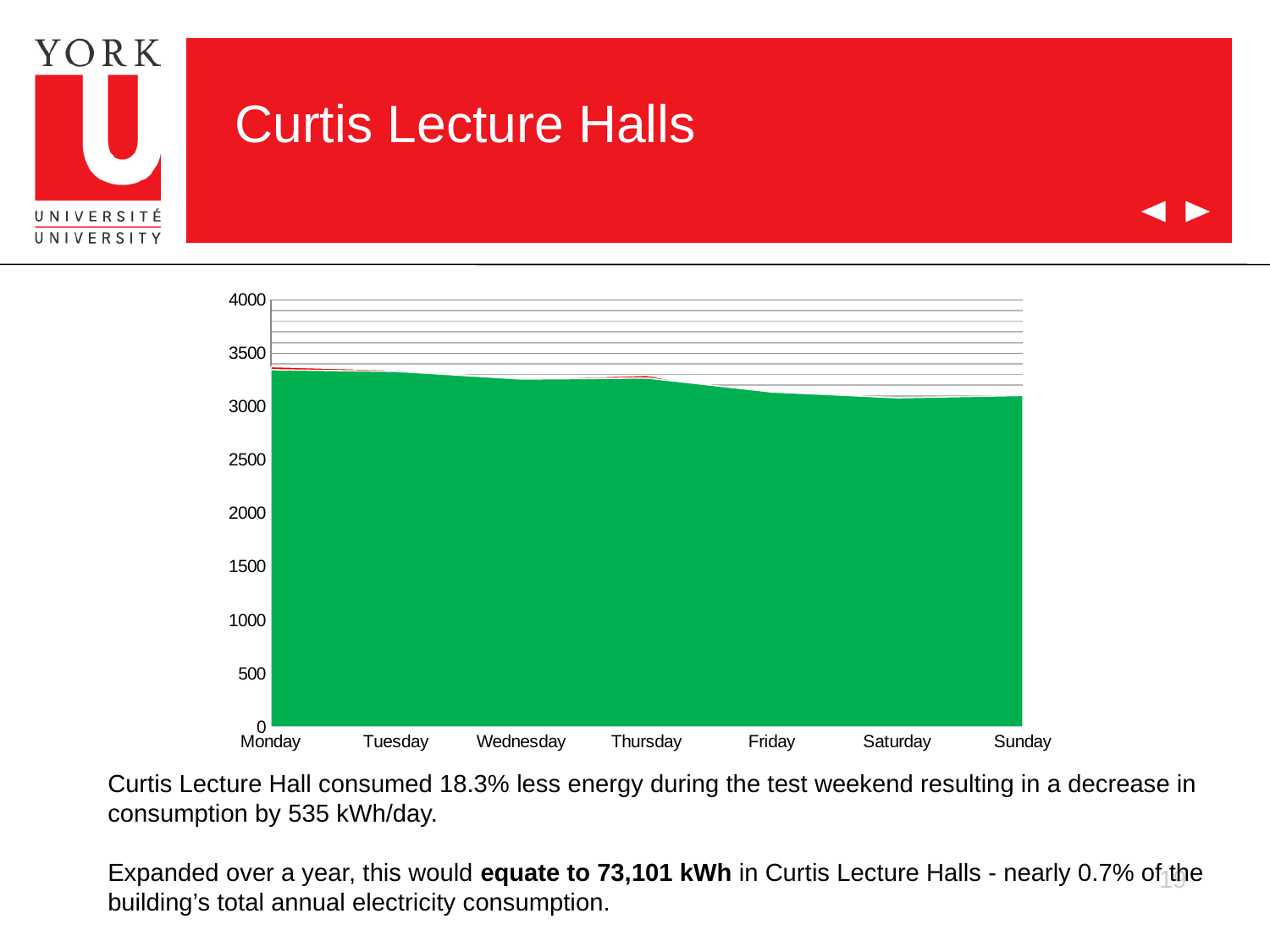
Do the values in the chart generally rise or fall from Monday to Sunday? fall Which is larger, the value for Thursday or the value for Friday? Thursday Which is larger, the value for Monday or the value for Sunday? Monday What colour is the filled area in the chart? green What kind of chart is shown on the slide? area chart Is the value for Sunday greater or less than 3000? greater Is the value for Monday greater or less than 3000? greater Is the value for Monday greater or less than 3500? less Which is larger, the value for Wednesday or the value for Saturday? Wednesday How many days are shown along the x axis of the chart? 7 What is the highest value shown on the y axis of the chart? 4000